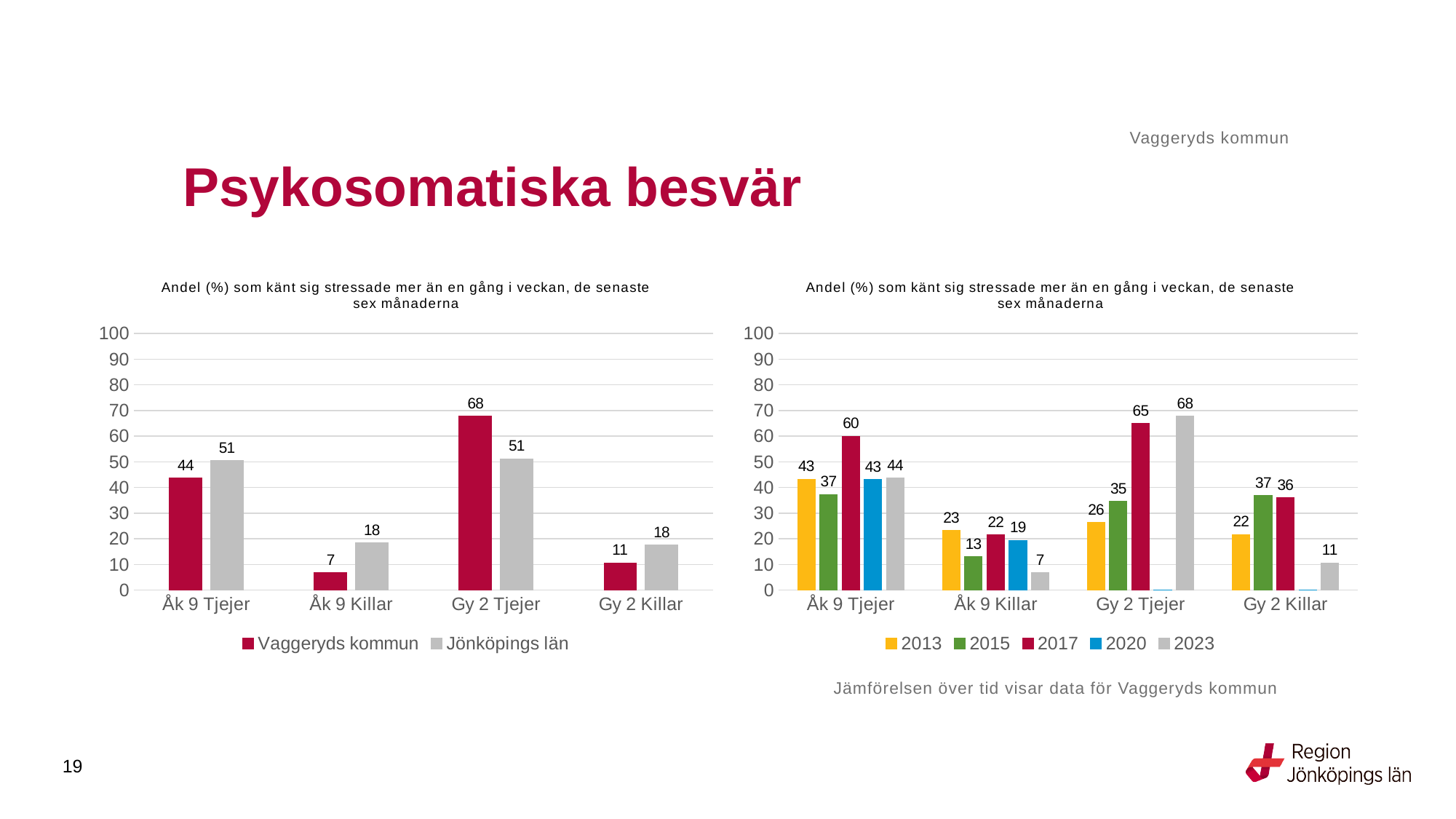
In the left chart, which category has the lowest value for Vaggeryds kommun? Åk 9 Killar In the right chart, how many series does the legend list? 5 In the left chart, how many series does the legend list? 2 What kind of chart is the right chart? Bar chart In the right chart, which year has the highest value for Gy 2 Tjejer? 2023 In the right chart, what is the value for 2017 for Åk 9 Tjejer? 60 In the left chart, what is the difference between Jönköpings län and Vaggeryds kommun for Åk 9 Tjejer? 7 In the left chart, which is larger for Gy 2 Tjejer: Vaggeryds kommun or Jönköpings län? Vaggeryds kommun In the left chart, what is the value for Vaggeryds kommun for Gy 2 Tjejer? 68 In the right chart, what is the value for 2023 for Gy 2 Killar? 11 In the left chart, what is the value for Jönköpings län for Åk 9 Killar? 18 In the right chart, what is the difference between the 2013 and 2023 values for Åk 9 Killar? 16